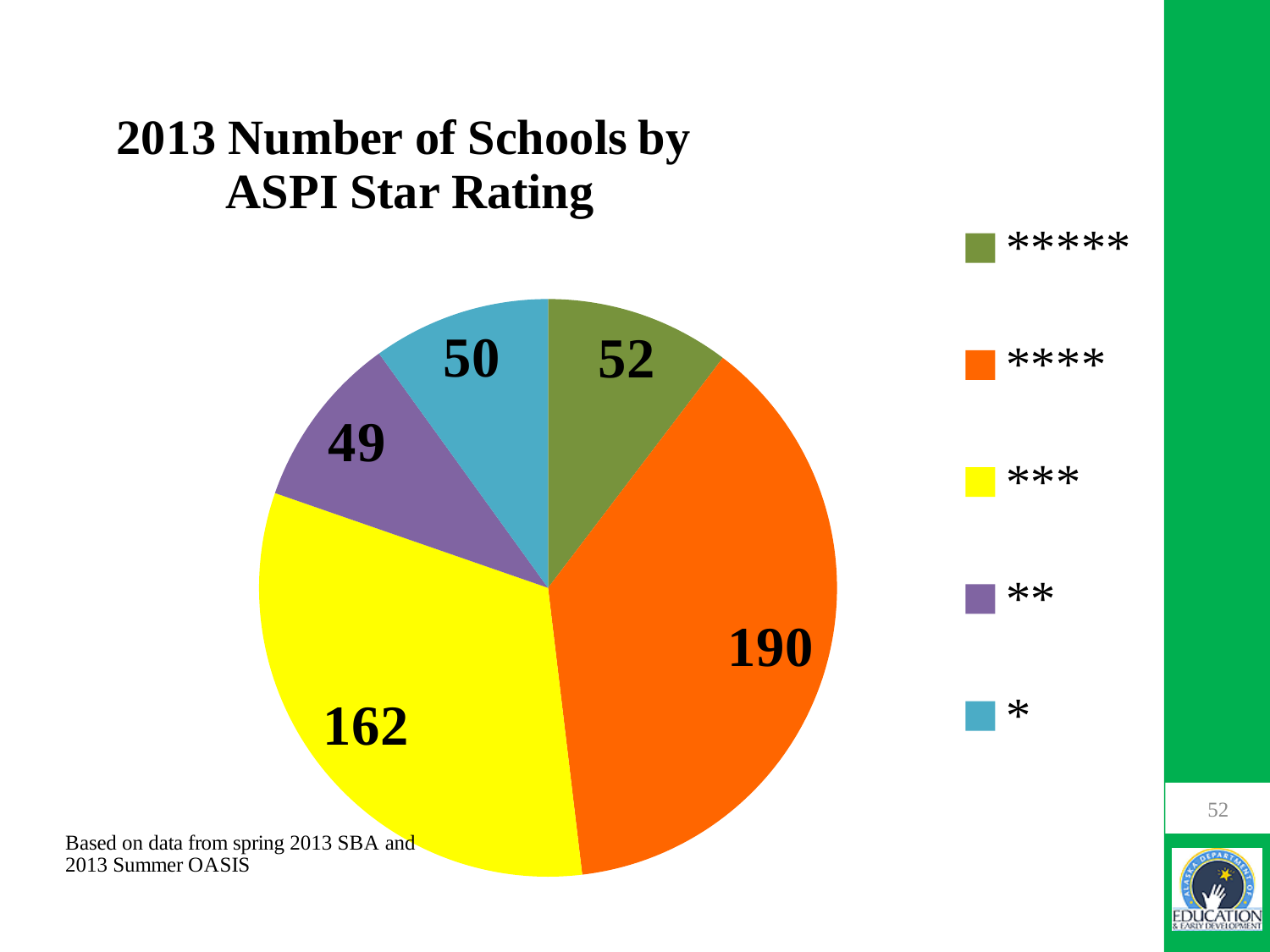
How many schools have a four-star (****) ASPI rating? 190 How many star-rating categories does the legend list? 5 What type of chart is shown on the slide? pie chart How many schools have a two-star (**) ASPI rating? 49 How many schools have a one-star (*) ASPI rating? 50 How many schools have a three-star (***) ASPI rating? 162 Which has more schools: the five-star (*****) rating or the three-star (***) rating? *** (three stars) What is the difference between the number of four-star (****) schools and three-star (***) schools? 28 Which star rating has the largest number of schools? **** (four stars) Which star rating has the smallest number of schools? ** (two stars) What is the title of the chart? 2013 Number of Schools by ASPI Star Rating How many schools have a five-star (*****) ASPI rating? 52